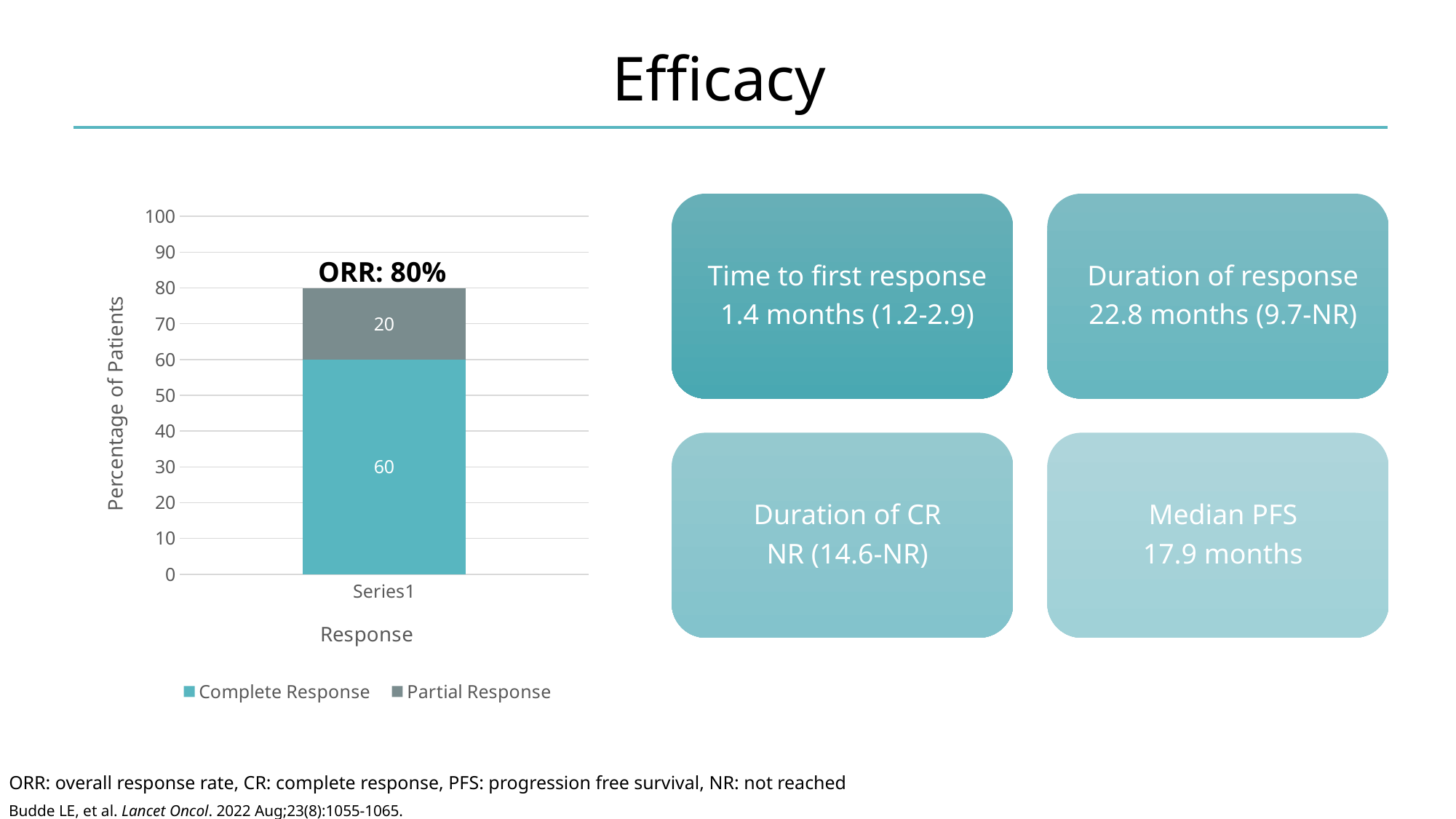
How many series does the legend list? 2 Which series has the largest value in the stacked bar? Complete Response Which is larger, the Complete Response value or the Partial Response value? Complete Response What kind of chart is shown on the slide? Stacked bar chart What is the ORR value labelled above the bar? 80% Which series has the smallest value in the stacked bar? Partial Response What is the total of the stacked bar for Series1? 80 What is the difference between the Complete Response and Partial Response values? 40 What is the value for Partial Response in the stacked bar? 20 What is the value for Complete Response in the stacked bar? 60 What is the label of the y axis? Percentage of Patients How many bars are plotted in the chart? 1